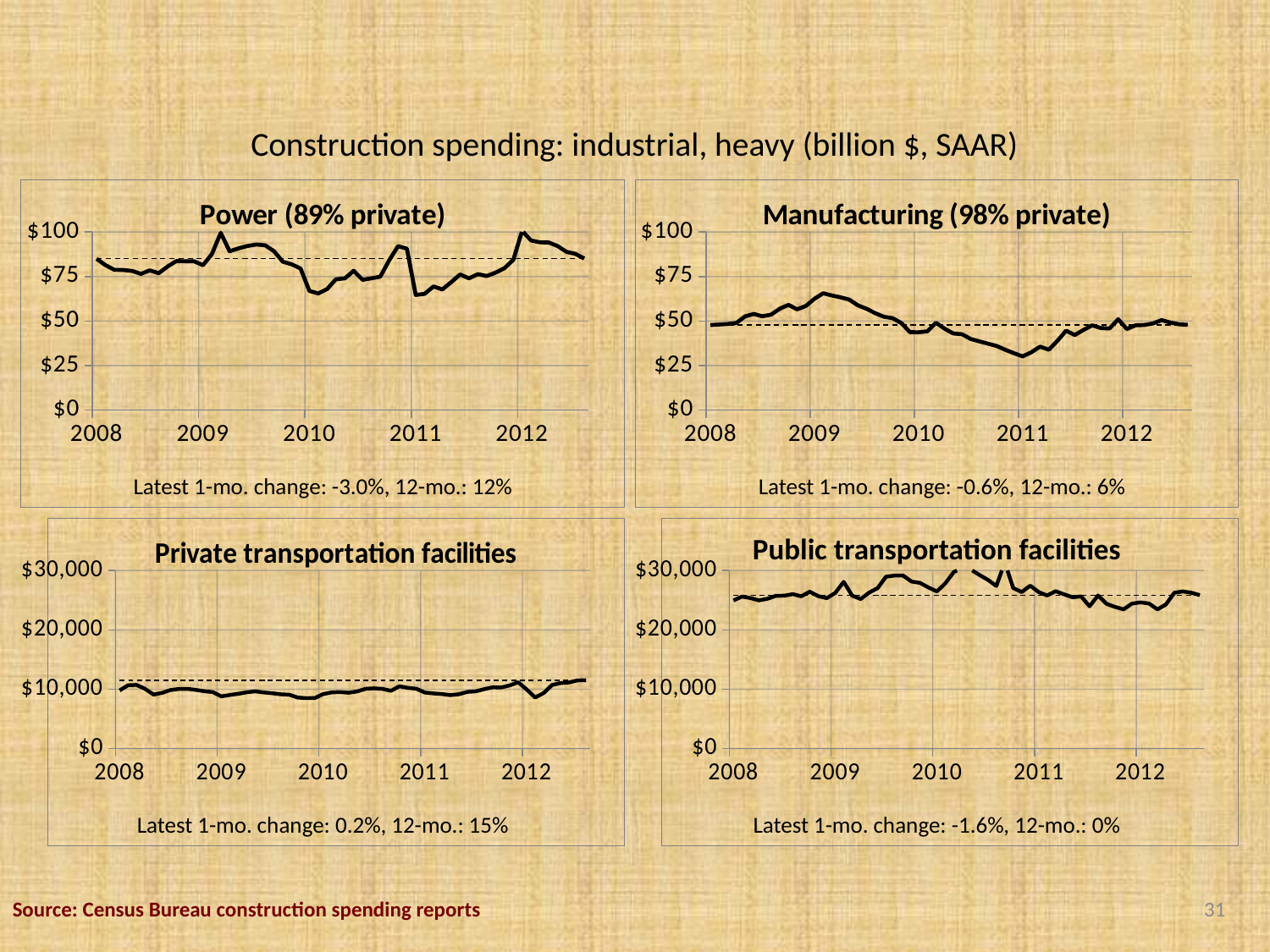
In the Public transportation facilities chart, what is the latest 12-month change stated below the chart? 0% In the Power (89% private) chart, what is the latest 1-month change stated below the chart? -3.0% How many charts are shown on the slide? 4 What kind of chart is the Power (89% private) chart? line chart In the Power (89% private) chart, is the value at the start of 2008 greater or less than $75? greater In the Public transportation facilities chart, is the value at the start of 2012 greater or less than $20,000? greater In the Manufacturing (98% private) chart, do values rise or fall between the start of 2009 and the start of 2011? fall In the Power (89% private) chart, what is the latest 12-month change stated below the chart? 12% In the Manufacturing (98% private) chart, is the value at the start of 2011 greater or less than $50? less What is the source cited at the bottom of the slide? Census Bureau construction spending reports In the Manufacturing (98% private) chart, what is the latest 12-month change stated below the chart? 6% In the Private transportation facilities chart, what is the latest 1-month change stated below the chart? 0.2%